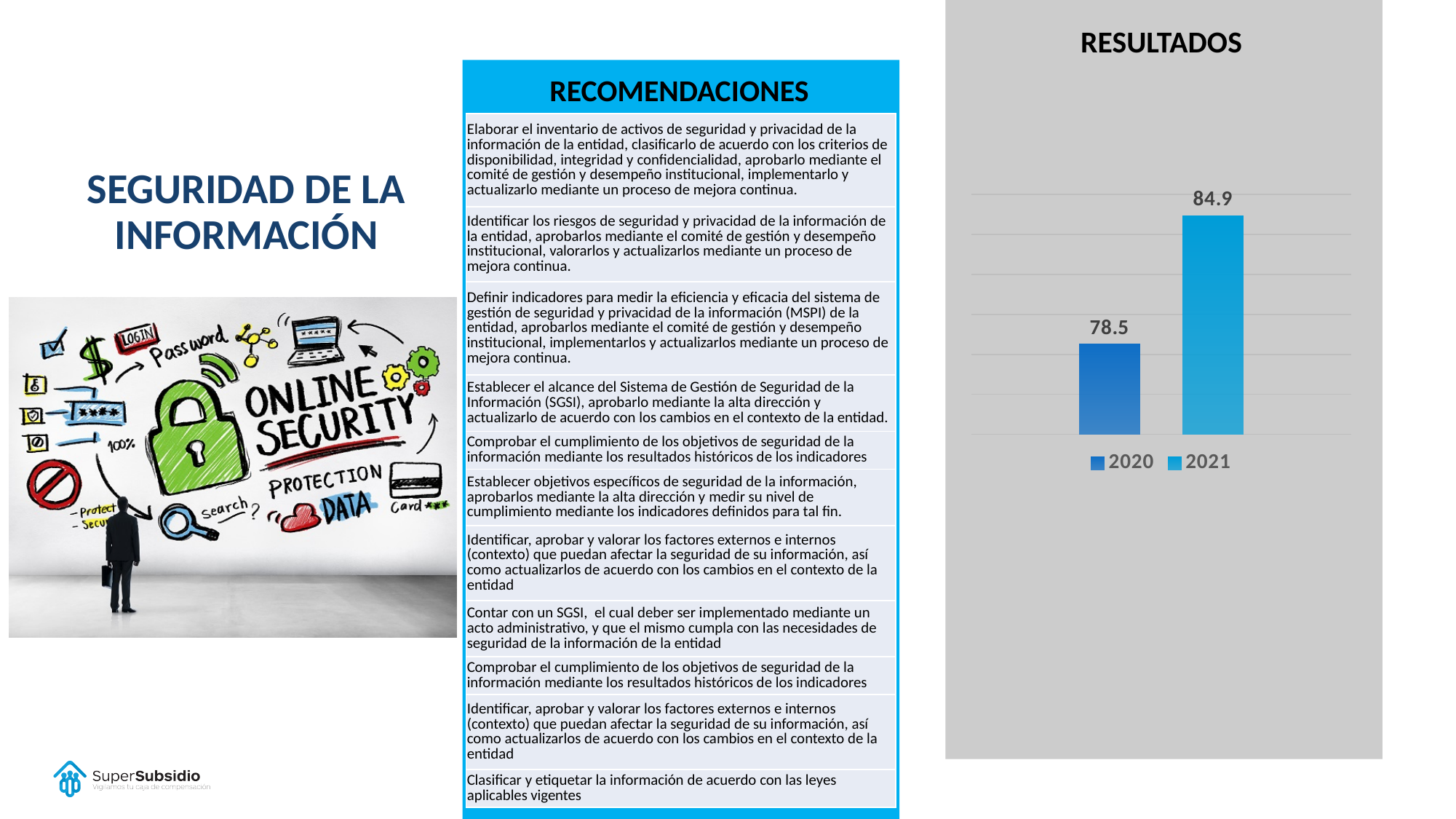
What is the title of the chart on the right side of the slide? RESULTADOS How many bars are plotted in the RESULTADOS chart? 2 How many series does the legend of the RESULTADOS chart list? 2 Which series has the higher value in the RESULTADOS chart, 2020 or 2021? 2021 What is the value for 2020 in the RESULTADOS chart? 78.5 Which series has the lowest value in the RESULTADOS chart? 2020 What is the difference between the 2021 and 2020 values in the RESULTADOS chart? 6.4 Do the values in the RESULTADOS chart rise or fall from 2020 to 2021? Rise What is the value for 2021 in the RESULTADOS chart? 84.9 Which years are listed in the legend of the RESULTADOS chart? 2020 and 2021 What kind of chart is shown under the title RESULTADOS? Bar chart